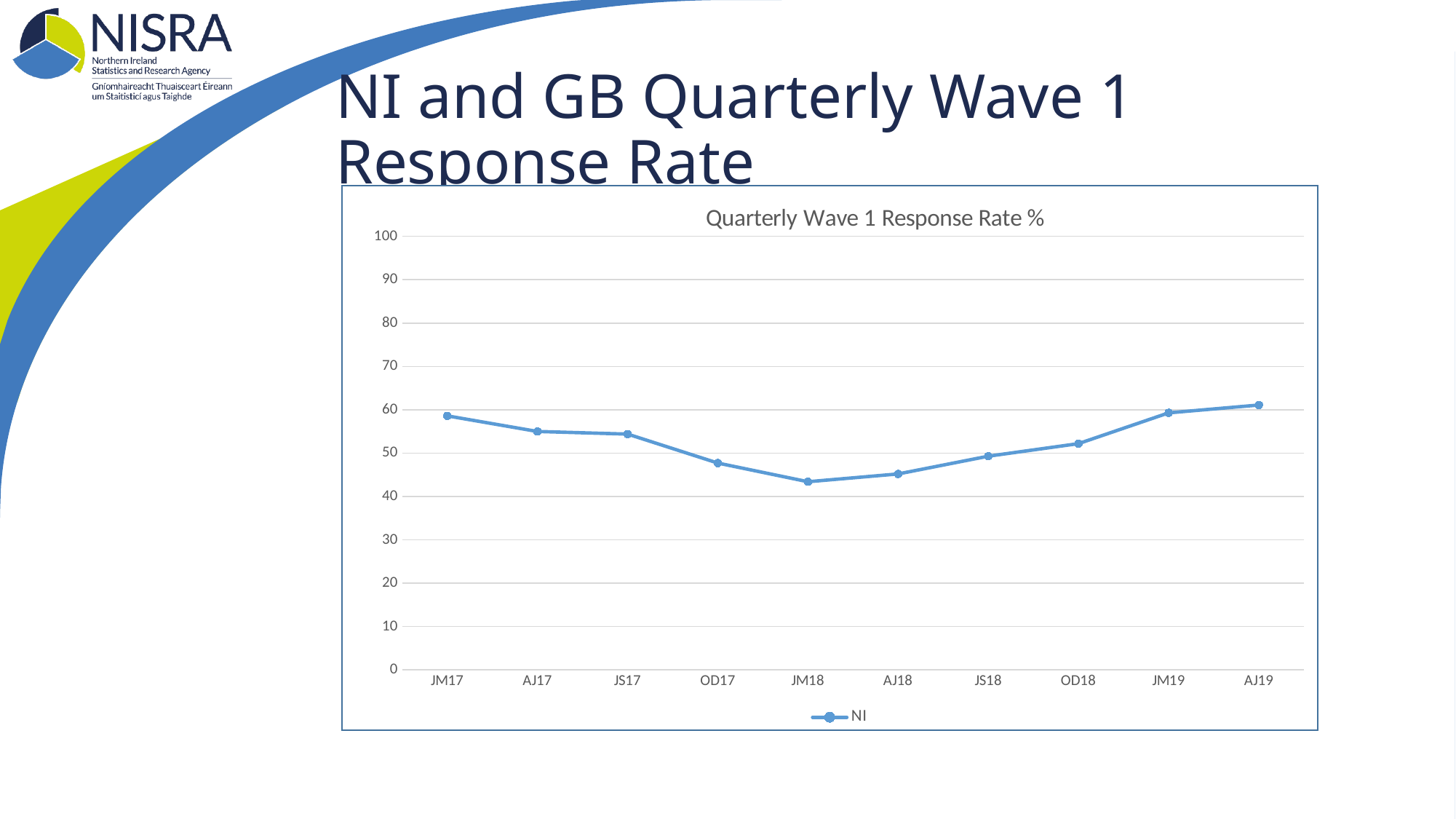
How many quarters are plotted along the x axis of the chart? 10 Is the NI response rate for AJ19 greater or less than 60? greater What kind of chart is shown on the slide? line chart What is the title shown inside the chart? Quarterly Wave 1 Response Rate % Is the NI response rate for OD17 greater or less than 50? less How many series does the chart's legend list? 1 Does the NI response rate rise or fall from JM18 to AJ19? rise Which is larger, the NI response rate for JS18 or for JM19? JM19 Which quarter has the highest NI response rate? AJ19 Which is larger, the NI response rate for JM17 or for OD17? JM17 Is the NI response rate for JM18 greater or less than 50? less Which quarter has the lowest NI response rate? JM18